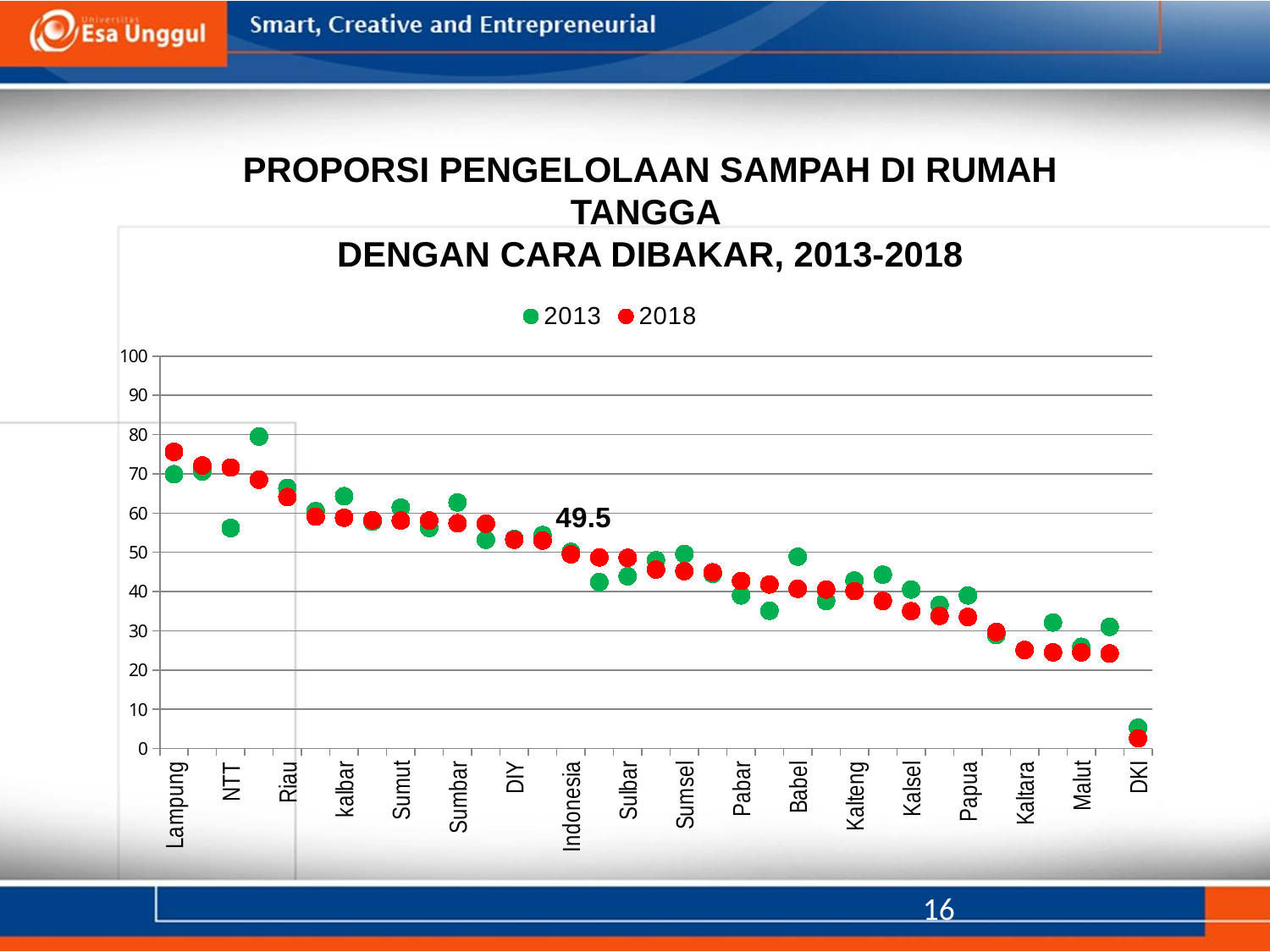
What is the 2018 value for Indonesia? 49.5 For NTT, which year has the larger value, 2013 or 2018? 2018 Is the 2013 value for NTT greater or less than 60? less Which years are shown in the legend? 2013 and 2018 For Babel, which year has the larger value, 2013 or 2018? 2013 Is the 2018 value for Lampung greater or less than 70? greater Is the 2018 value for Kaltara greater or less than 30? less Which labelled province has the lowest 2018 value? DKI How many series does the legend list? 2 What type of chart is shown on the slide? Scatter (dot) chart Do the values generally rise or fall moving from left to right along the x axis? fall